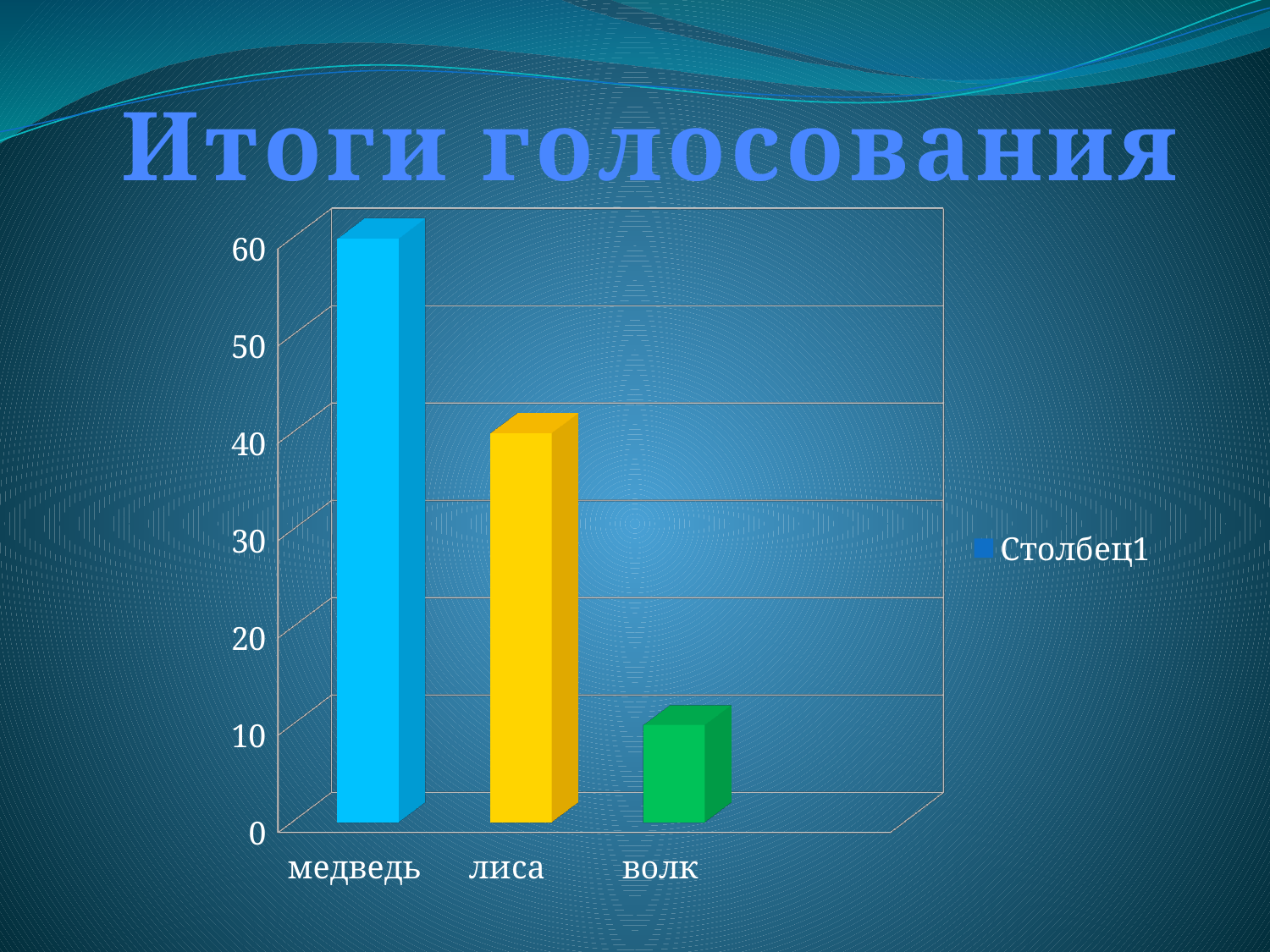
What is the difference between the values for медведь and лиса? 20 Is the value for медведь greater or less than 50? greater Which is larger, the value for лиса or the value for волк? лиса How many categories are shown on the x axis? 3 What is the title of the slide above the chart? Итоги голосования Which category has the highest value? медведь What kind of chart is shown on the slide? bar chart Which category has the lowest value? волк What is the difference between the values for лиса and волк? 30 What is the value for волк? 10 What is the value for лиса? 40 What is the value for медведь? 60